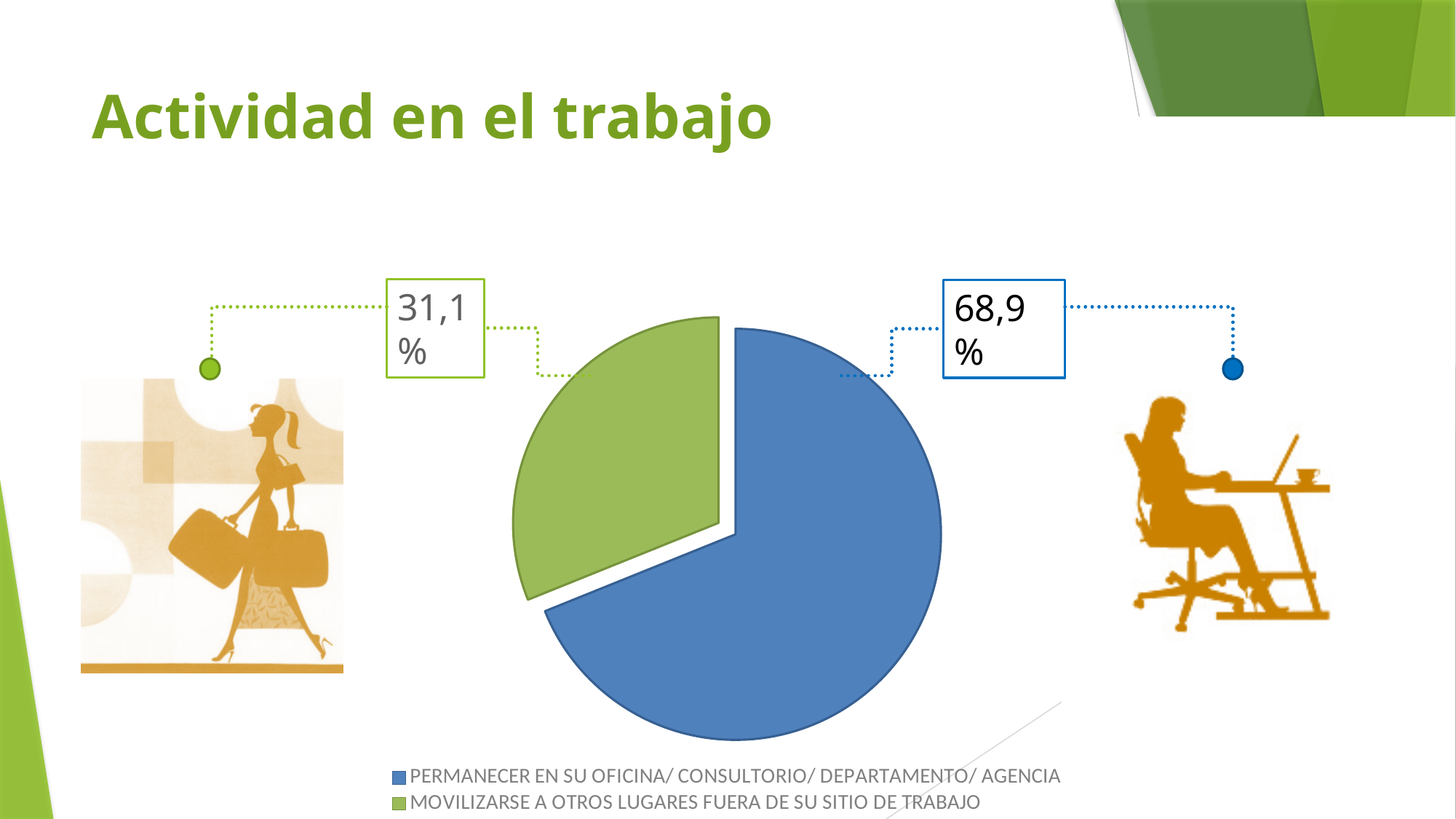
What share of the pie does the blue slice represent? 68,9% What kind of chart is shown on the slide? pie chart What is the difference in percentage points between the two slices? 37,8 Which is larger: the slice for PERMANECER EN SU OFICINA or the slice for MOVILIZARSE A OTROS LUGARES? PERMANECER EN SU OFICINA/ CONSULTORIO/ DEPARTAMENTO/ AGENCIA What colour is the slice for MOVILIZARSE A OTROS LUGARES FUERA DE SU SITIO DE TRABAJO? green What is the value for MOVILIZARSE A OTROS LUGARES FUERA DE SU SITIO DE TRABAJO? 31,1% How many entries does the legend list? 2 Which category has the smallest slice of the pie? MOVILIZARSE A OTROS LUGARES FUERA DE SU SITIO DE TRABAJO How many slices does the pie chart have? 2 What is the value for PERMANECER EN SU OFICINA/ CONSULTORIO/ DEPARTAMENTO/ AGENCIA? 68,9% What is the title of the slide? Actividad en el trabajo Which category has the largest slice of the pie? PERMANECER EN SU OFICINA/ CONSULTORIO/ DEPARTAMENTO/ AGENCIA